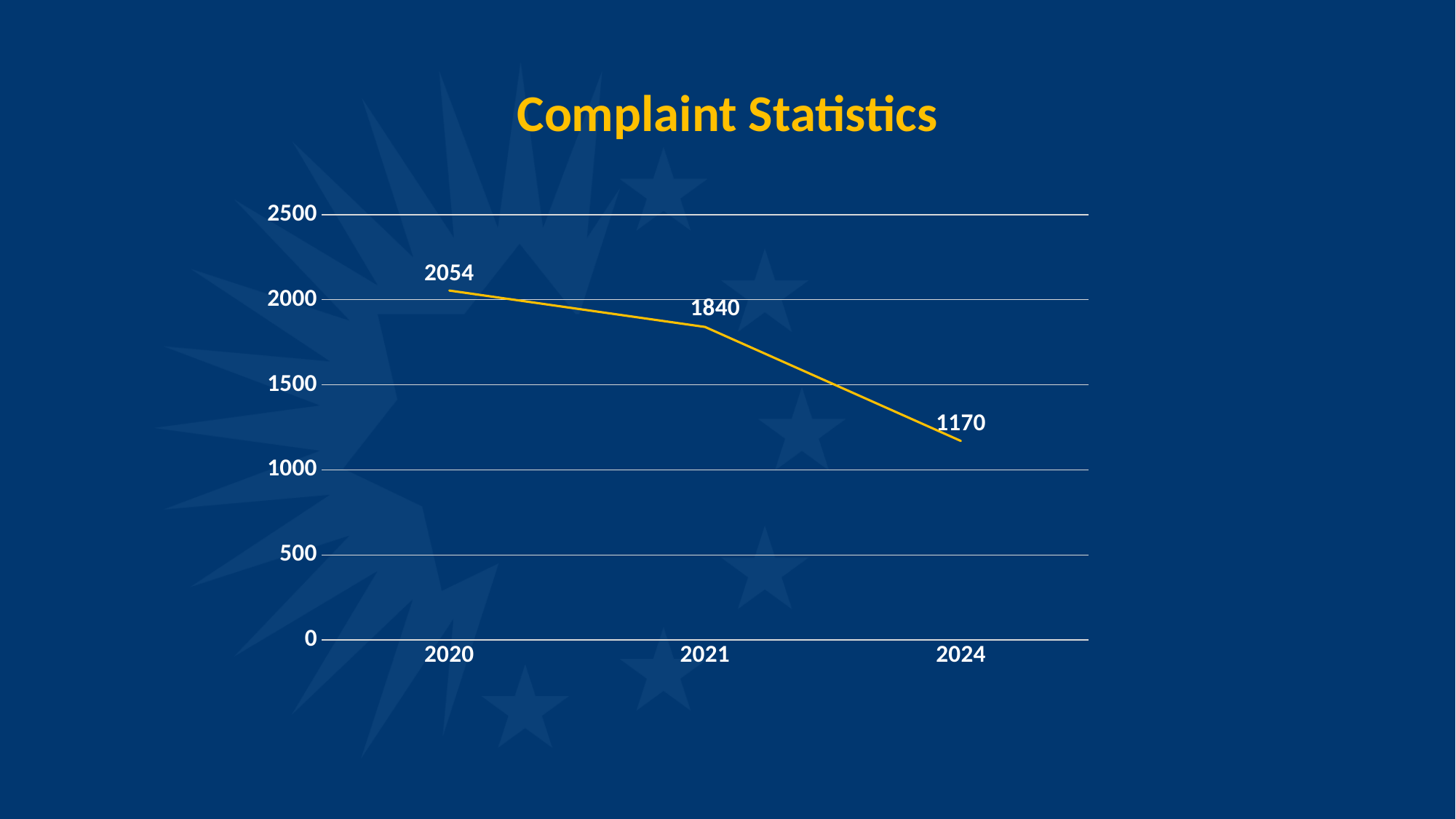
How many years are plotted on the chart? 3 Which is larger, the value for 2020 or the value for 2021? 2020 What is the difference between the values for 2020 and 2024? 884 Which year has the lowest value? 2024 Is the value for 2024 greater or less than 1500? less What is the difference between the values for 2021 and 2024? 670 What is the value for 2020? 2054 What is the value for 2021? 1840 What is the value for 2024? 1170 Which year has the highest value? 2020 What kind of chart is shown? line chart Do the values rise or fall from 2020 to 2024? fall